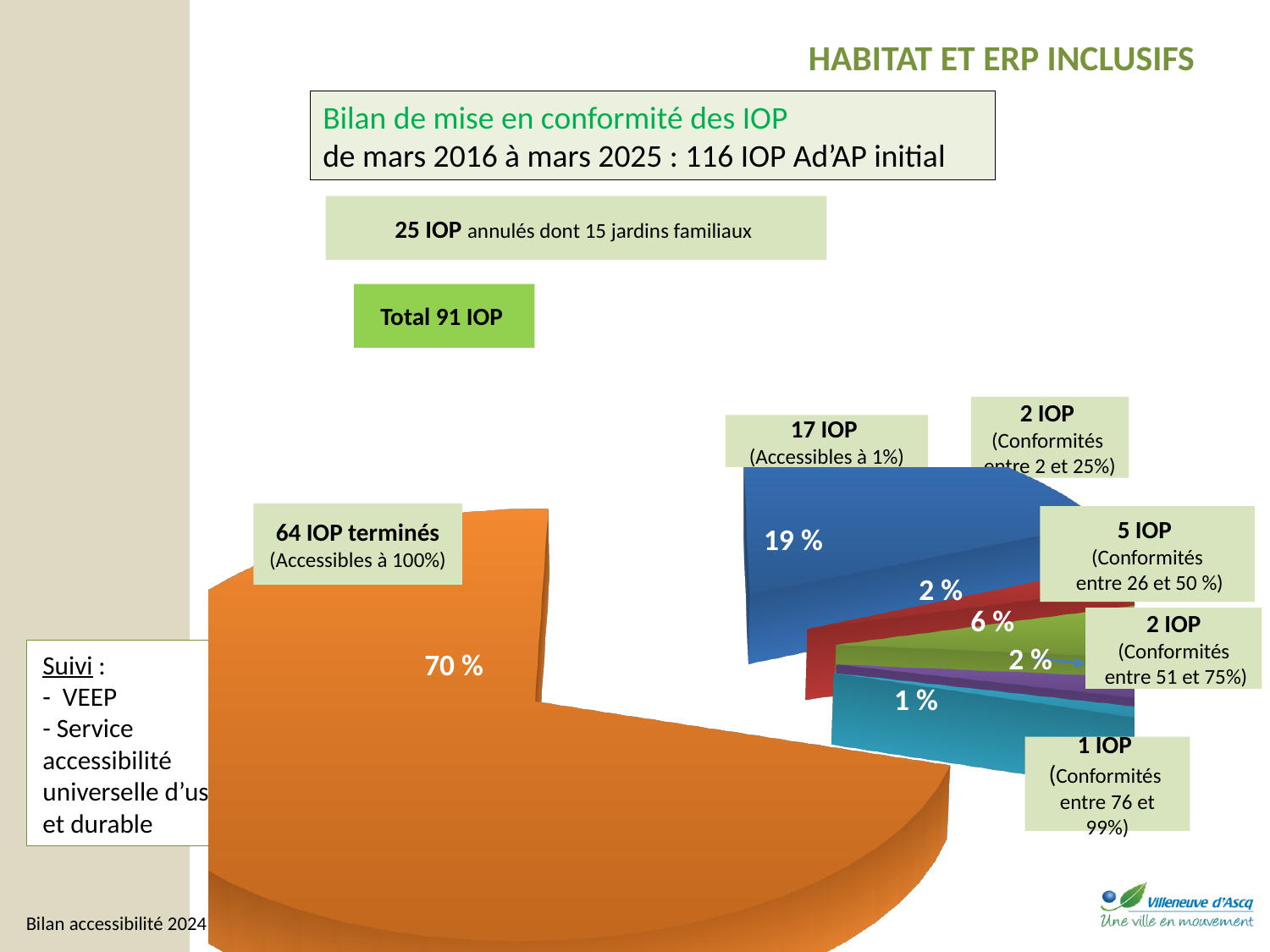
How many IOP does the pie chart represent in total, according to the slide? 91 IOP What is the difference in percentage points between the 64 IOP terminés slice and the 17 IOP (Accessibles à 1%) slice? 51 What percentage of the pie is the slice for the 64 IOP terminés (Accessibles à 100%)? 70 % How many slices does the pie chart have? 6 What colour is the largest slice of the pie chart? orange What kind of chart is shown on the slide? pie chart What percentage is shown for the 5 IOP (Conformités entre 26 et 50 %) slice? 6 % What percentage is shown for the 17 IOP (Accessibles à 1%) slice? 19 % Which slice of the pie chart is the smallest? 1 IOP (Conformités entre 76 et 99%) Which is larger: the slice for 17 IOP (Accessibles à 1%) or the slice for 5 IOP (Conformités entre 26 et 50 %)? 17 IOP (Accessibles à 1%) What percentage is shown for the 1 IOP (Conformités entre 76 et 99%) slice? 1 % Which slice of the pie chart is the largest? 64 IOP terminés (Accessibles à 100%)